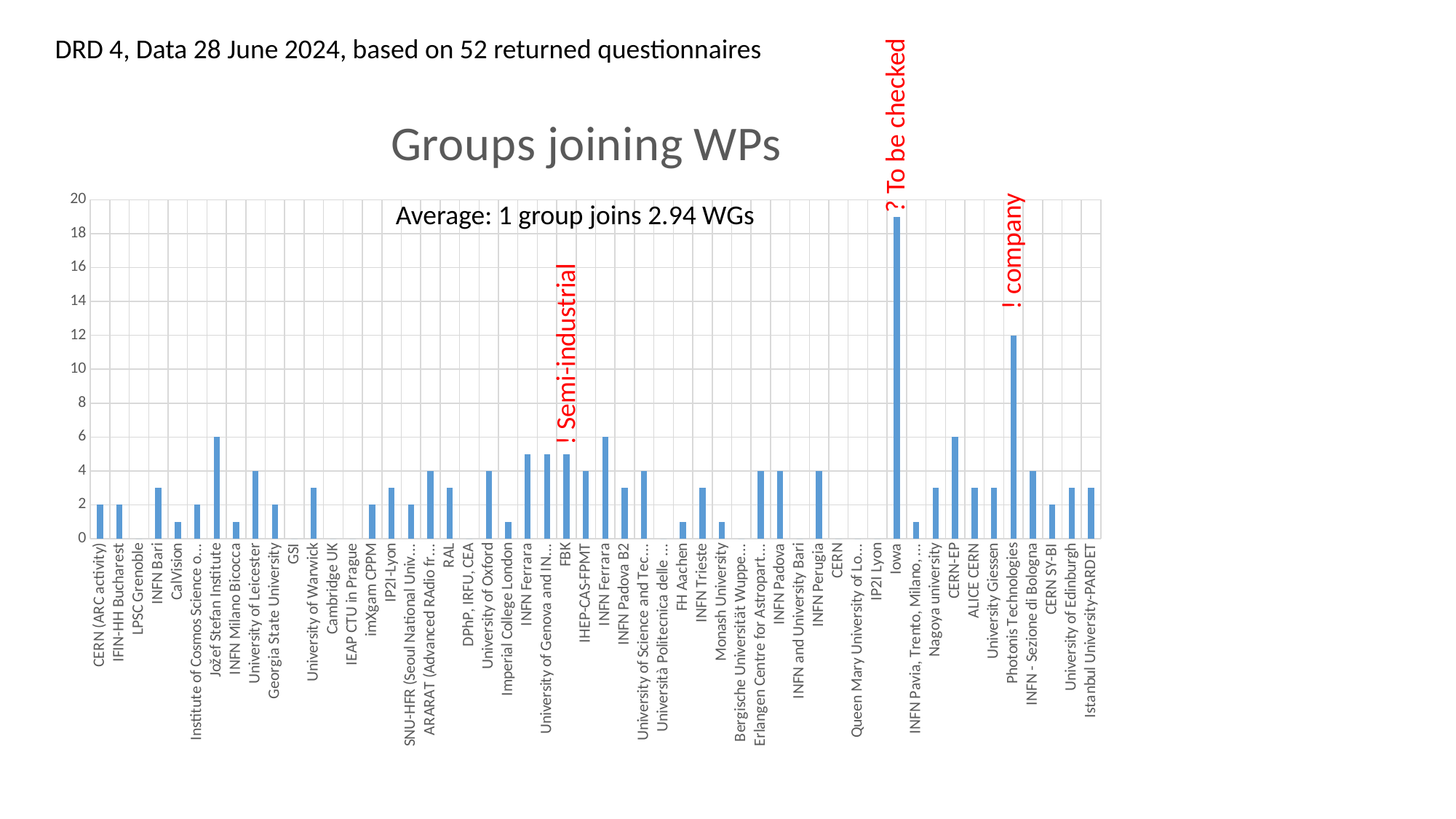
According to the text on the chart, how many WGs does 1 group join on average? 2.94 What is the difference between the values for Photonis Technologies and CERN-EP? 6 What type of chart is shown on the slide? bar chart What is the value for University of Leicester? 4 What is the title of the chart? Groups joining WPs What is the value for IFIN-HH Bucharest? 2 What is the value for CERN-EP? 6 Is the value for FBK greater or less than 4? greater Is the value for Iowa greater or less than 18? greater Which group has the highest bar in the chart? Iowa What is the value for Photonis Technologies? 12 What is the value for Jožef Stefan Institute? 6